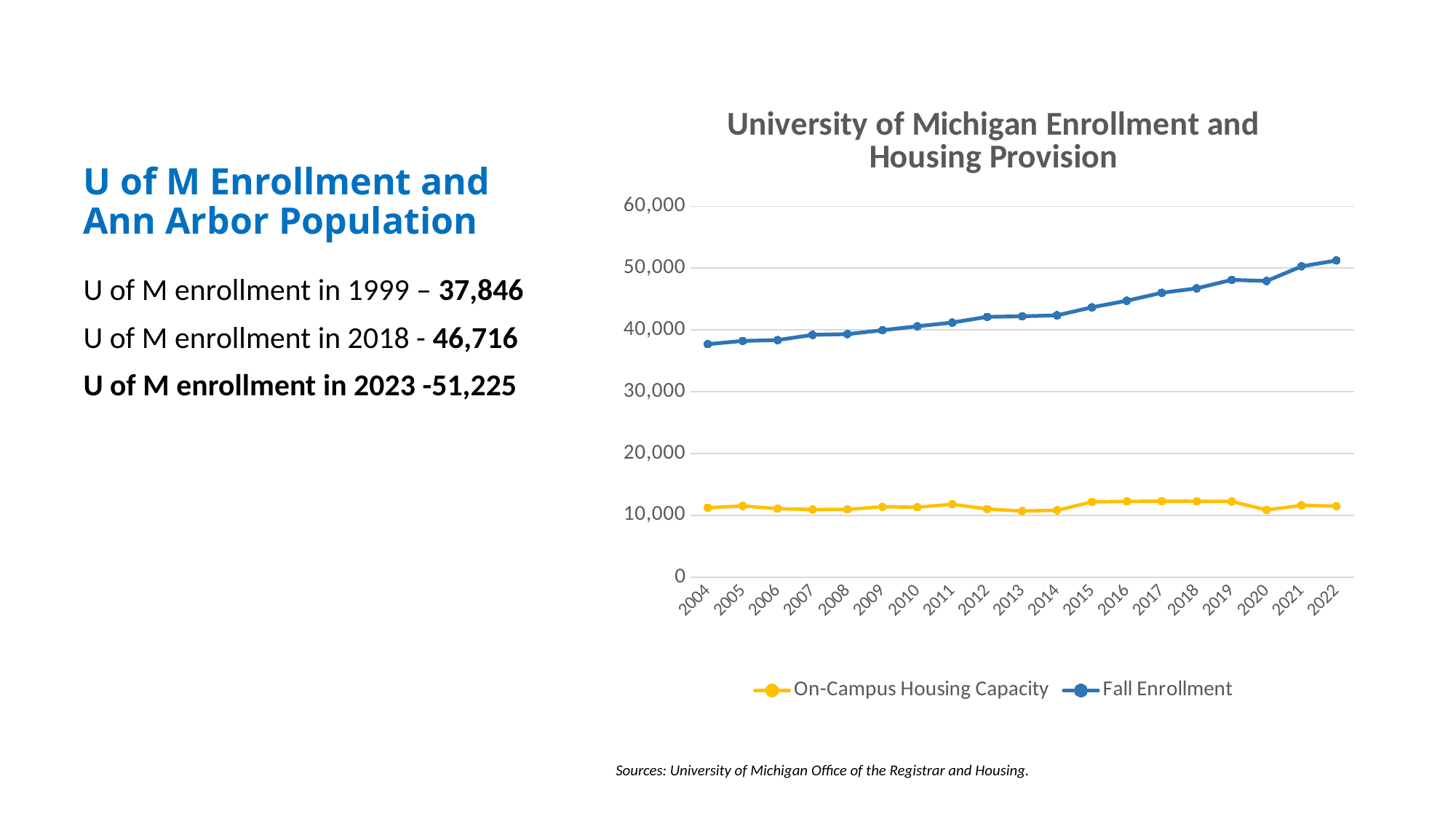
What is the title of the chart? University of Michigan Enrollment and Housing Provision In which year is Fall Enrollment lowest? 2004 How many series does the chart's legend list? 2 Is the Fall Enrollment value for 2019 greater or less than 40,000? greater What kind of chart is shown on the slide? line chart In which year is Fall Enrollment highest? 2022 Is the Fall Enrollment value for 2004 greater or less than 40,000? less Is the On-Campus Housing Capacity value for 2011 greater or less than 10,000? greater Does Fall Enrollment generally rise or fall from 2004 to 2022? rise How many years are plotted along the x axis of the chart? 19 In 2010, which is larger: Fall Enrollment or On-Campus Housing Capacity? Fall Enrollment